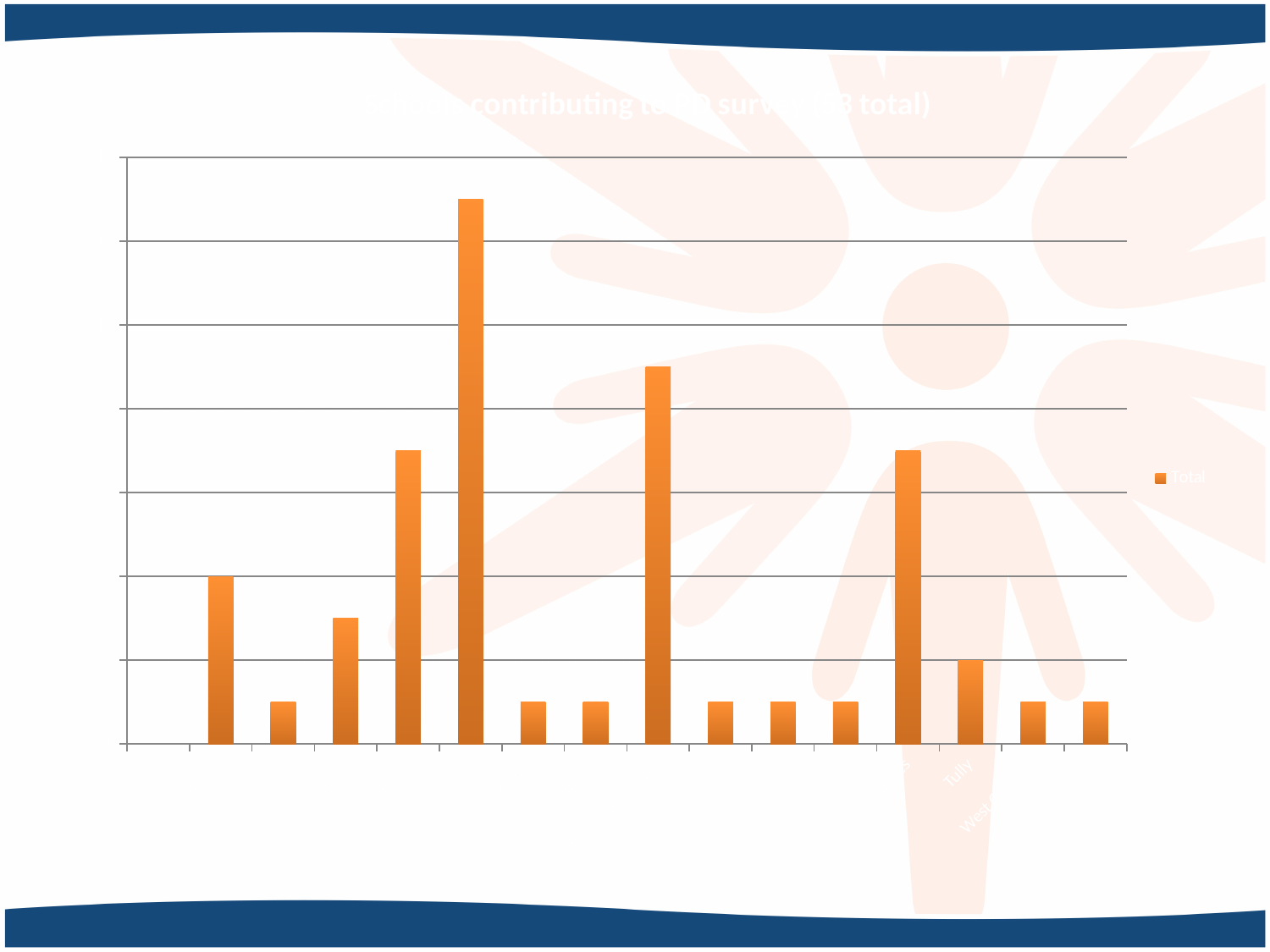
Is the bar for Tully taller or shorter than the bar immediately to its left? shorter What is the name of the series shown in the legend? Total How many series does the legend list? 1 What kind of chart is shown on the slide? bar chart What colour are the bars in the chart? orange